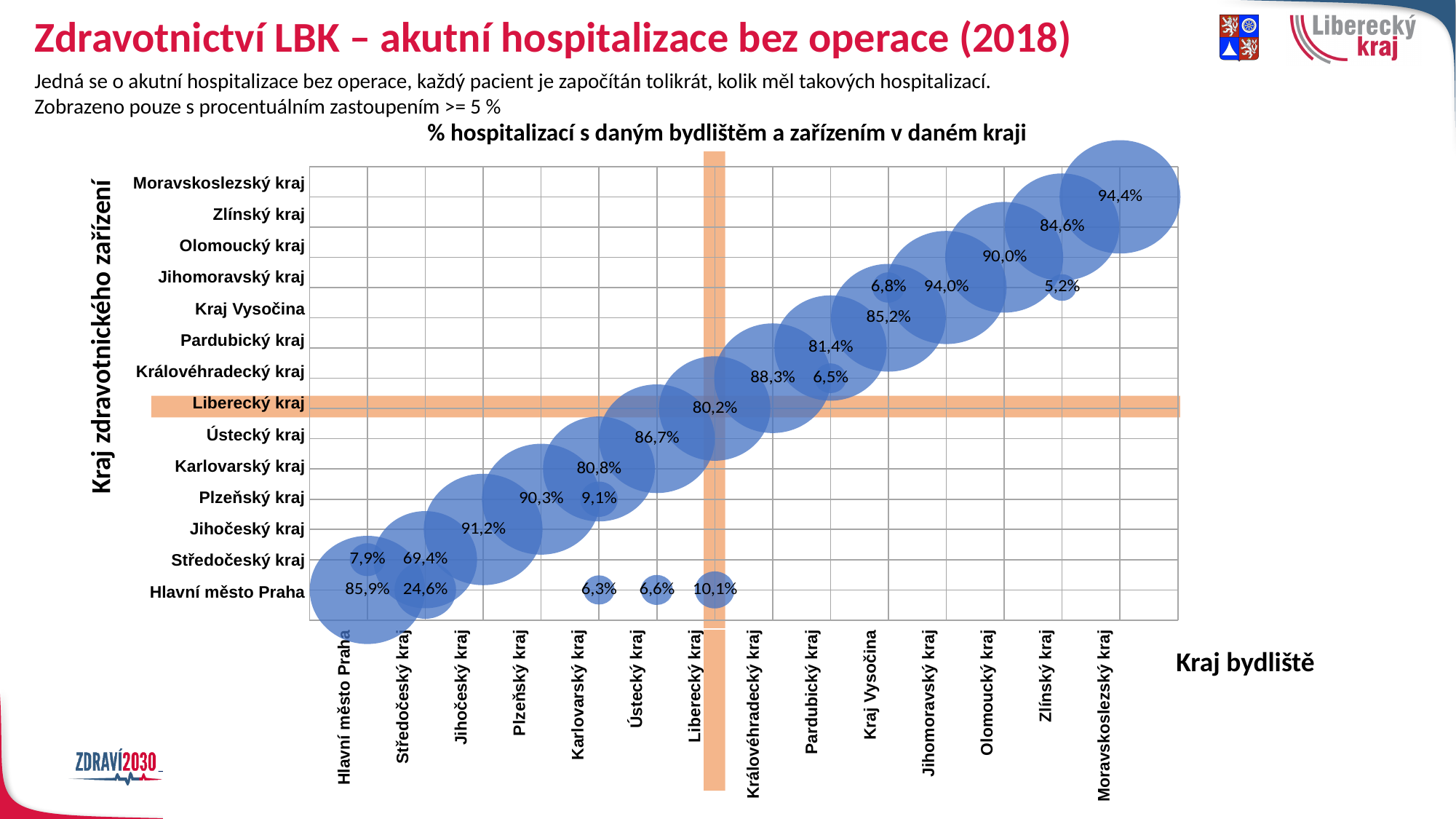
What percentage of patients residing in Karlovarský kraj were hospitalised in a facility in Plzeňský kraj? 9,1% Which is larger: the share of Praha residents hospitalised in Středočeský kraj or the share of Středočeský kraj residents hospitalised in Praha? Středočeský kraj residents hospitalised in Praha (24,6%) Which region is highlighted with orange bands on both axes of the chart? Liberecký kraj What percentage of patients residing in Liberecký kraj were hospitalised in a facility in Hlavní město Praha? 10,1% Which region of residence has the highest share of hospitalisations in a facility of its own region? Moravskoslezský kraj What percentage of patients residing in Liberecký kraj were hospitalised in a facility in Liberecký kraj? 80,2% How many regions of residence are listed on the x axis? 14 What is the smallest percentage value labelled on the chart? 5,2% What percentage of patients residing in Středočeský kraj were hospitalised in a facility in Hlavní město Praha? 24,6% Which region of residence has the lowest share of hospitalisations in a facility of its own region? Středočeský kraj What kind of chart is shown on the slide? Bubble chart